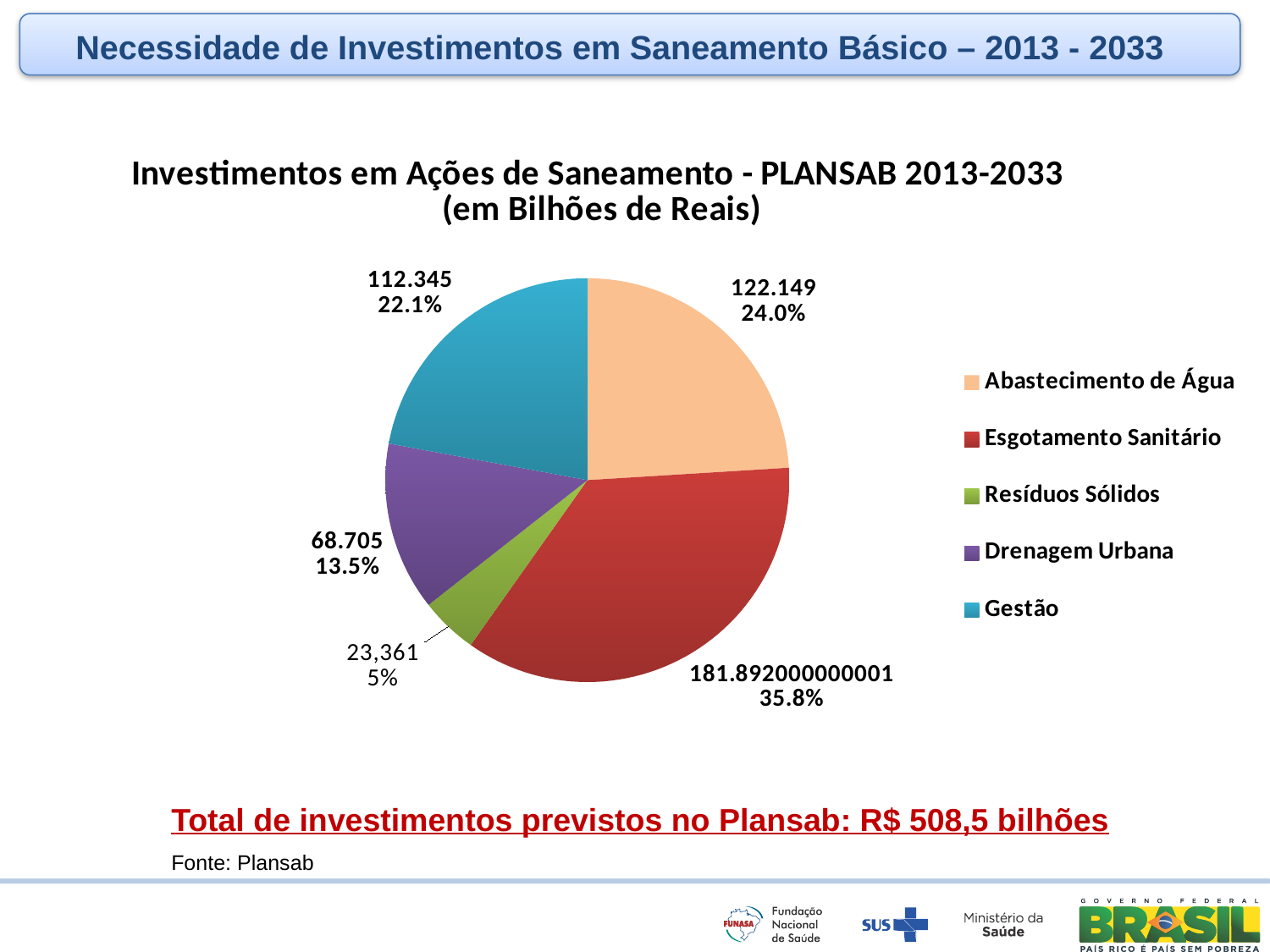
What share of the pie does Esgotamento Sanitário represent? 35.8% Which is larger, the value for Abastecimento de Água or the value for Gestão? Abastecimento de Água What kind of chart is shown on the slide? pie chart What value is shown for Drenagem Urbana? 68.705 What is the title of the chart? Investimentos em Ações de Saneamento - PLANSAB 2013-2033 (em Bilhões de Reais) What share of the pie does Resíduos Sólidos represent? 5% What value is shown for Abastecimento de Água? 122.149 How many slices does the pie chart have? 5 Which category has the smallest slice of the pie? Resíduos Sólidos How many entries does the legend list? 5 Which category has the largest slice of the pie? Esgotamento Sanitário What value is shown for Gestão? 112.345